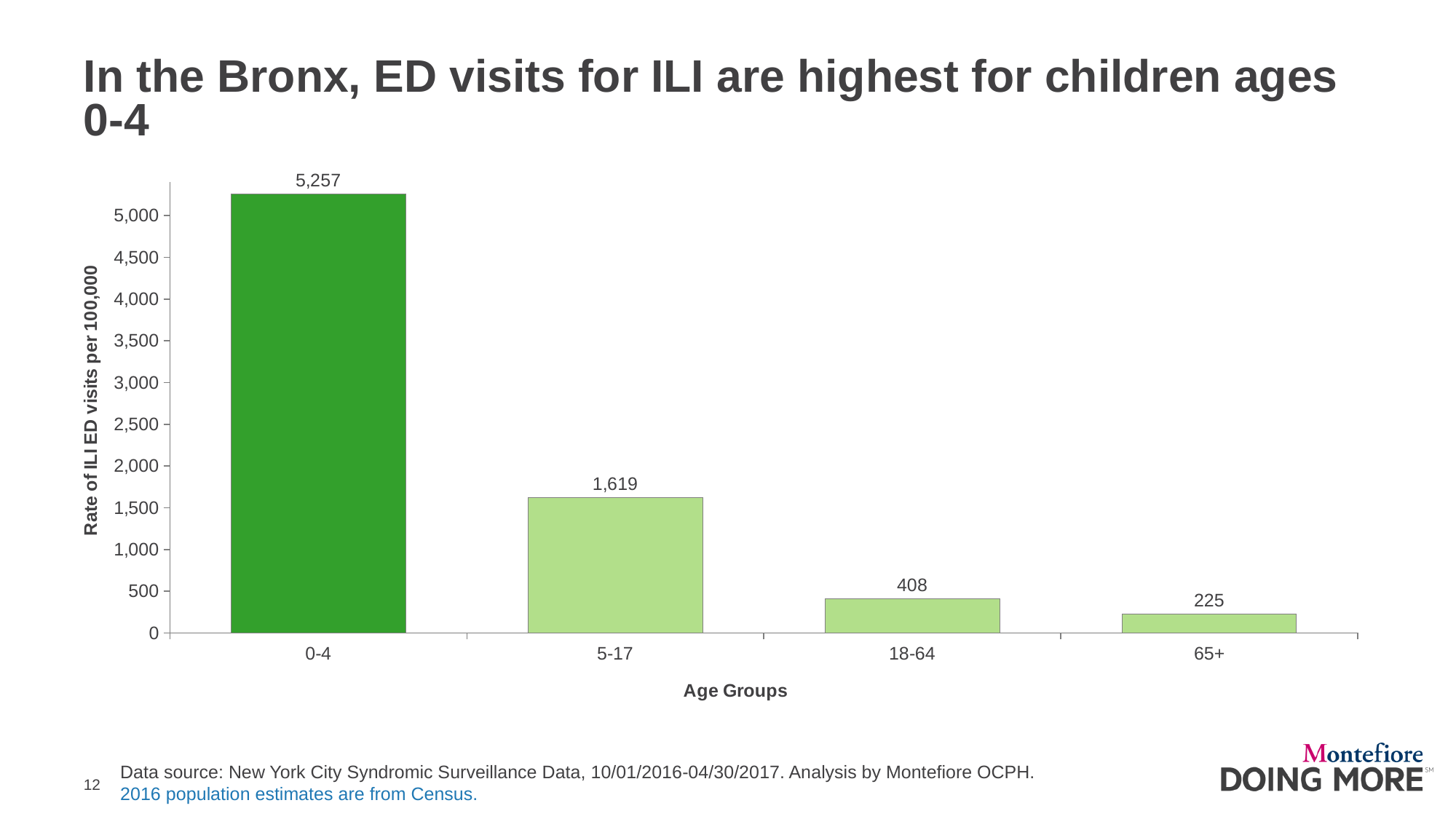
What is the rate of ILI ED visits per 100,000 for the 5-17 age group? 1,619 Do the values rise or fall as the age groups move from left to right along the x axis? Fall Which age group has the highest rate of ILI ED visits? 0-4 What is the difference in the rate of ILI ED visits between the 18-64 and 65+ age groups? 183 What is the rate of ILI ED visits per 100,000 for the 0-4 age group? 5,257 What is the rate of ILI ED visits per 100,000 for the 18-64 age group? 408 What type of chart is shown on the slide? Bar chart What is the rate of ILI ED visits per 100,000 for the 65+ age group? 225 How many age groups are shown in the chart? 4 What is the difference in the rate of ILI ED visits between the 0-4 and 5-17 age groups? 3,638 Which age group has a higher rate of ILI ED visits, 5-17 or 18-64? 5-17 Which age group has the lowest rate of ILI ED visits? 65+